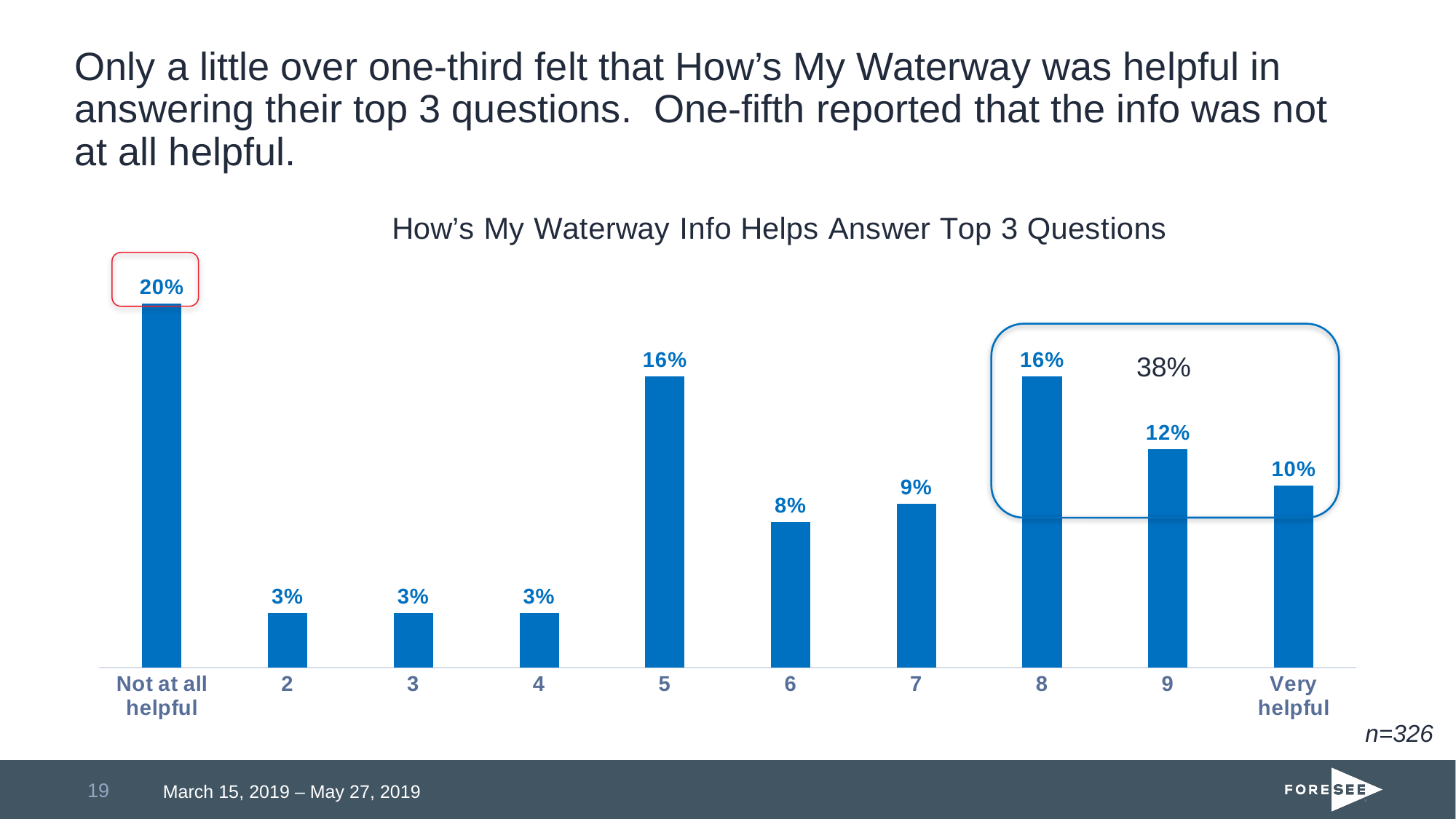
What is the value shown for the 'Very helpful' category? 10% Which is larger, the value for rating 7 or the value for rating 9? Rating 9 What percentage of respondents rated How's My Waterway as 'Not at all helpful'? 20% What type of chart is shown on the slide? Bar chart What is the difference between the value for 'Not at all helpful' and the value for 'Very helpful'? 10% Which category has the highest value in the chart? Not at all helpful How many categories share the lowest value of 3%? 3 What is the combined total of the values for ratings 8, 9 and 'Very helpful', as highlighted on the chart? 38% What percentage is shown for rating 6? 8% What sample size (n) is noted below the chart? n=326 What is the title of the chart? How's My Waterway Info Helps Answer Top 3 Questions How many categories are shown on the x axis of the chart? 10